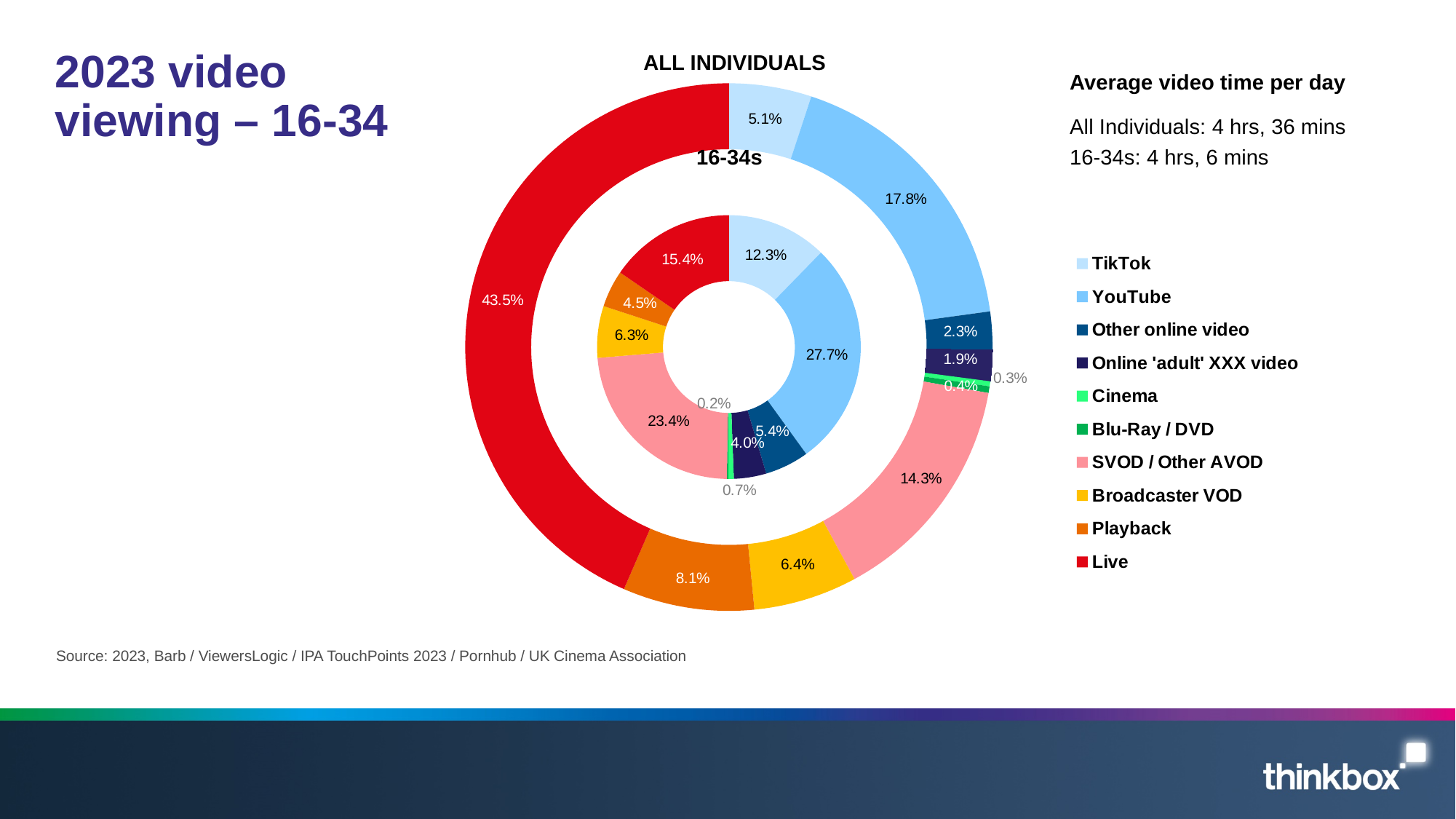
In the ALL INDIVIDUALS ring, what share is SVOD / Other AVOD? 14.3% What is the difference between the Live share for ALL INDIVIDUALS (43.5%) and for 16-34s (15.4%)? 28.1% Which category has the largest share in the 16-34s ring? YouTube How many categories does the legend list? 10 In the 16-34s ring, what share of video viewing is TikTok? 12.3% According to the slide, what is the average video time per day for 16-34s? 4 hrs, 6 mins Which category has the largest share in the ALL INDIVIDUALS ring? Live What type of chart is shown on the slide? Doughnut chart In the ALL INDIVIDUALS ring, what share is Playback? 8.1% In the 16-34s ring, what share of video viewing is YouTube? 27.7% Which is larger: the YouTube share for 16-34s or the YouTube share for ALL INDIVIDUALS? 16-34s In the ALL INDIVIDUALS ring, what share of video viewing is Live? 43.5%